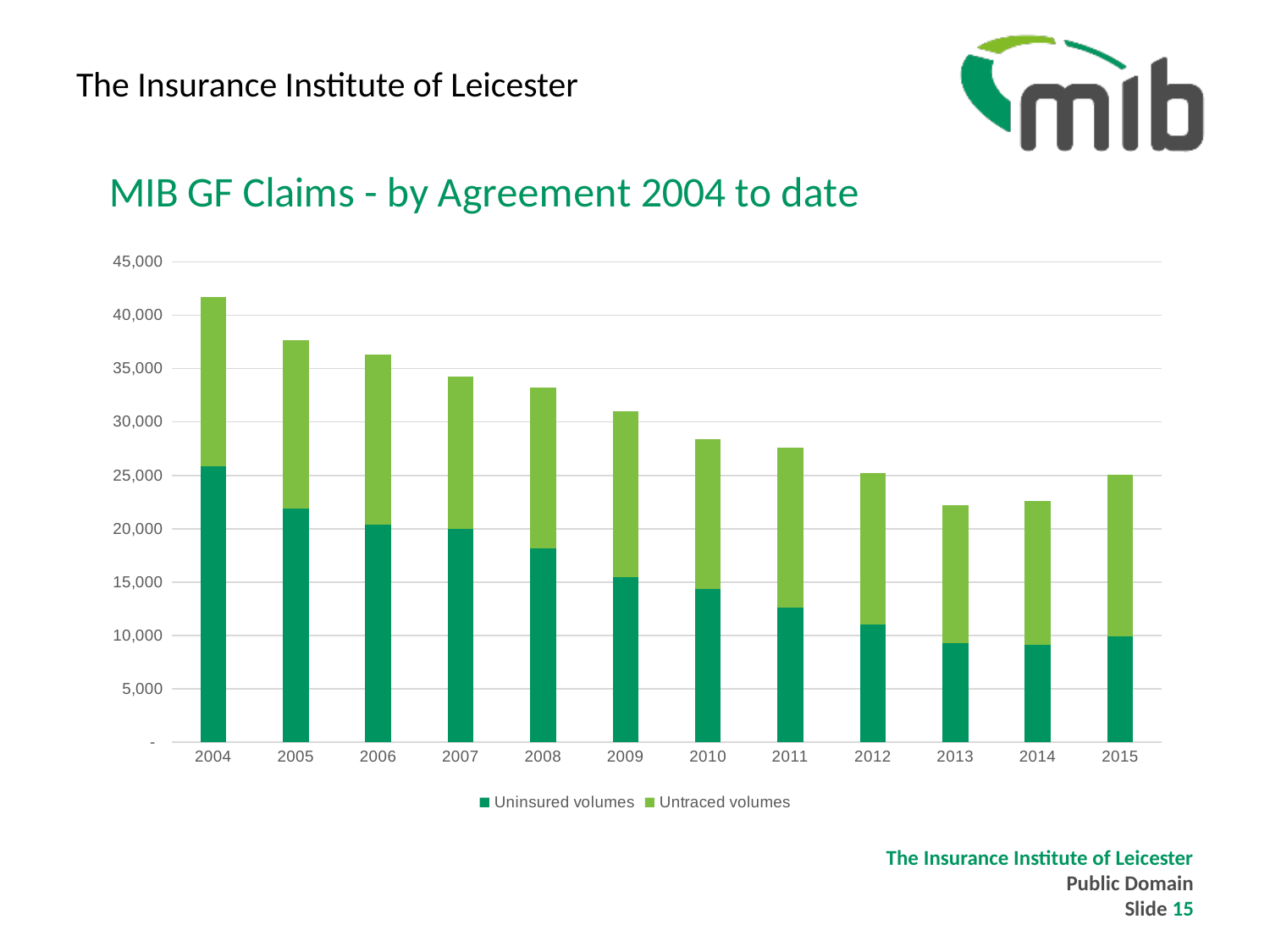
Is the total claims volume for 2004 greater or less than 40,000? greater What kind of chart is shown on the slide? Stacked bar chart How many years are shown on the x axis? 12 Is the Uninsured volumes value for 2008 greater or less than 20,000? less Is the total claims volume for 2013 greater or less than 25,000? less How many series does the legend list? 2 Which year has the highest Uninsured volumes value? 2004 Do the total claims volumes generally rise or fall from 2004 to 2015? fall What is the title of the chart? MIB GF Claims - by Agreement 2004 to date Which is larger, the total claims volume for 2004 or for 2015? 2004 Which year has the highest total claims volume? 2004